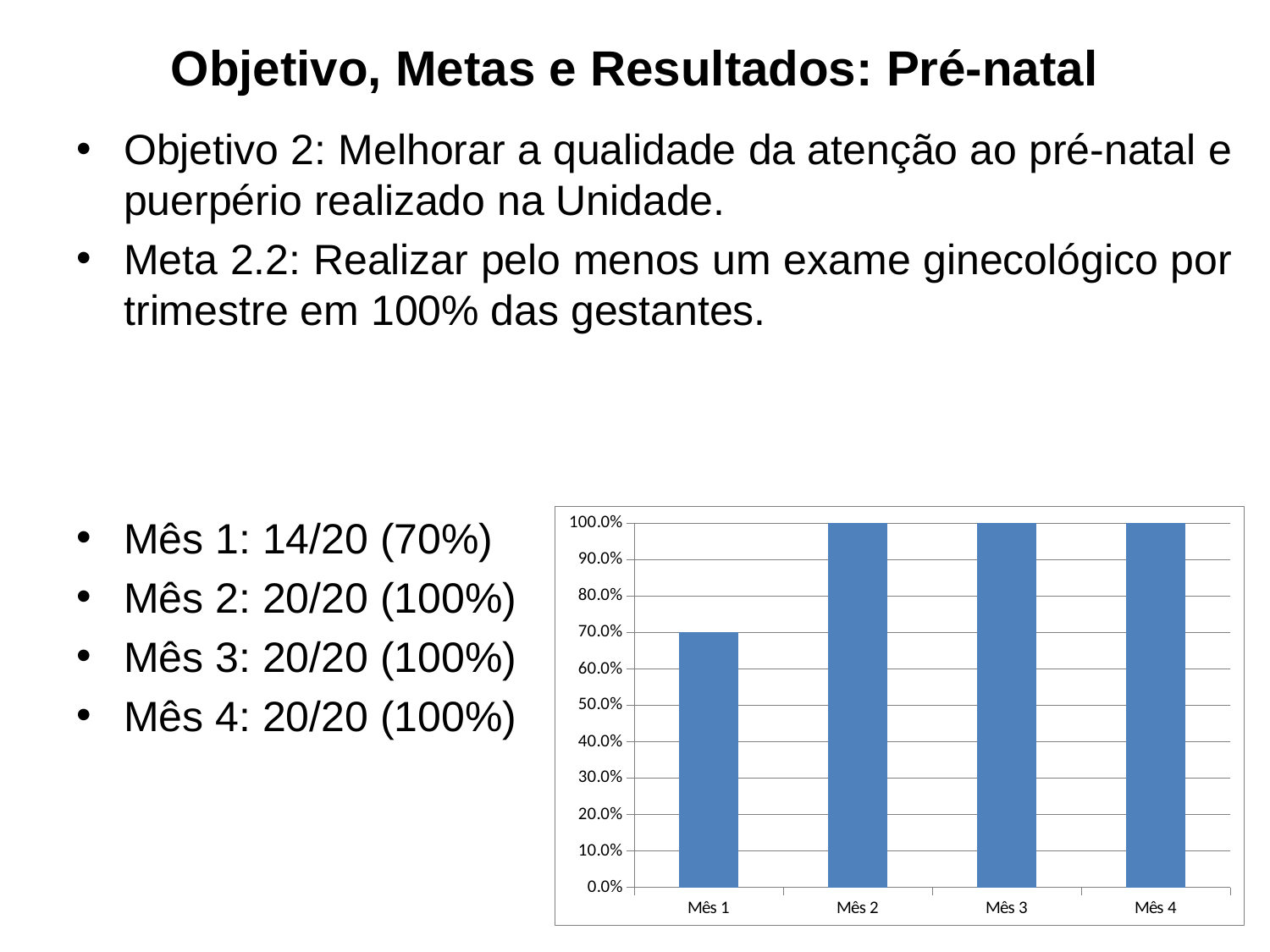
Which is larger, the value for Mês 1 or the value for Mês 3? Mês 3 How many months are shown on the x axis of the chart? 4 Is the value for Mês 1 greater or less than 80.0%? less Do the values rise or fall from Mês 1 to Mês 2? rise What colour are the bars in the chart? blue What kind of chart is shown on the slide? bar chart Is the value for Mês 3 greater or less than 90.0%? greater What is the difference between the values for Mês 2 and Mês 1? 30.0% What is the value for Mês 1 in the chart? 70.0% What is the value for Mês 2 in the chart? 100.0% Which month has the lowest value in the chart? Mês 1 What is the value for Mês 4 in the chart? 100.0%